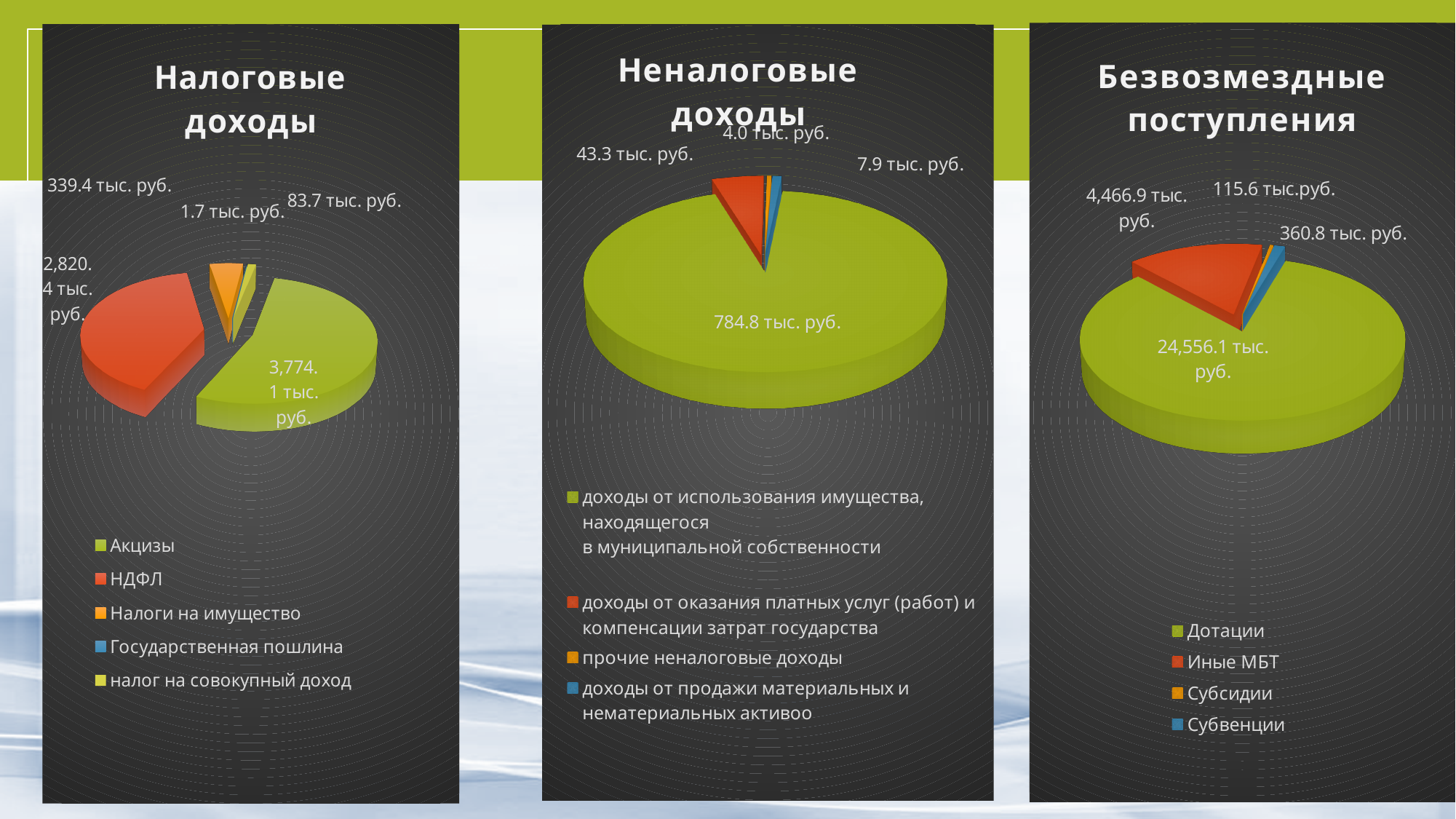
In the 'Неналоговые доходы' chart, what is the value for доходы от оказания платных услуг (работ) и компенсации затрат государства? 43.3 тыс. руб. In the 'Безвозмездные поступления' chart, what is the value for Дотации? 24,556.1 тыс. руб. How many pie charts are shown on the slide? 3 In the 'Неналоговые доходы' chart, what is the difference between the largest slice (784.8 тыс. руб.) and the slice for доходы от оказания платных услуг (43.3 тыс. руб.)? 741.5 тыс. руб. In the 'Налоговые доходы' chart, which category has the smallest value? Государственная пошлина In the 'Безвозмездные поступления' chart, what is the difference between Дотации and Иные МБТ? 20,089.2 тыс. руб. In the 'Налоговые доходы' chart, what is the value for Акцизы? 3,774.1 тыс. руб. What kind of chart is used for 'Налоговые доходы'? Pie chart In the 'Налоговые доходы' chart, what is the value for НДФЛ? 2,820.4 тыс. руб. In the 'Неналоговые доходы' chart, which category has the largest value? доходы от использования имущества, находящегося в муниципальной собственности In the 'Безвозмездные поступления' chart, which is larger: Субсидии or Субвенции? Субвенции In the 'Налоговые доходы' chart, how many categories does the legend list? 5